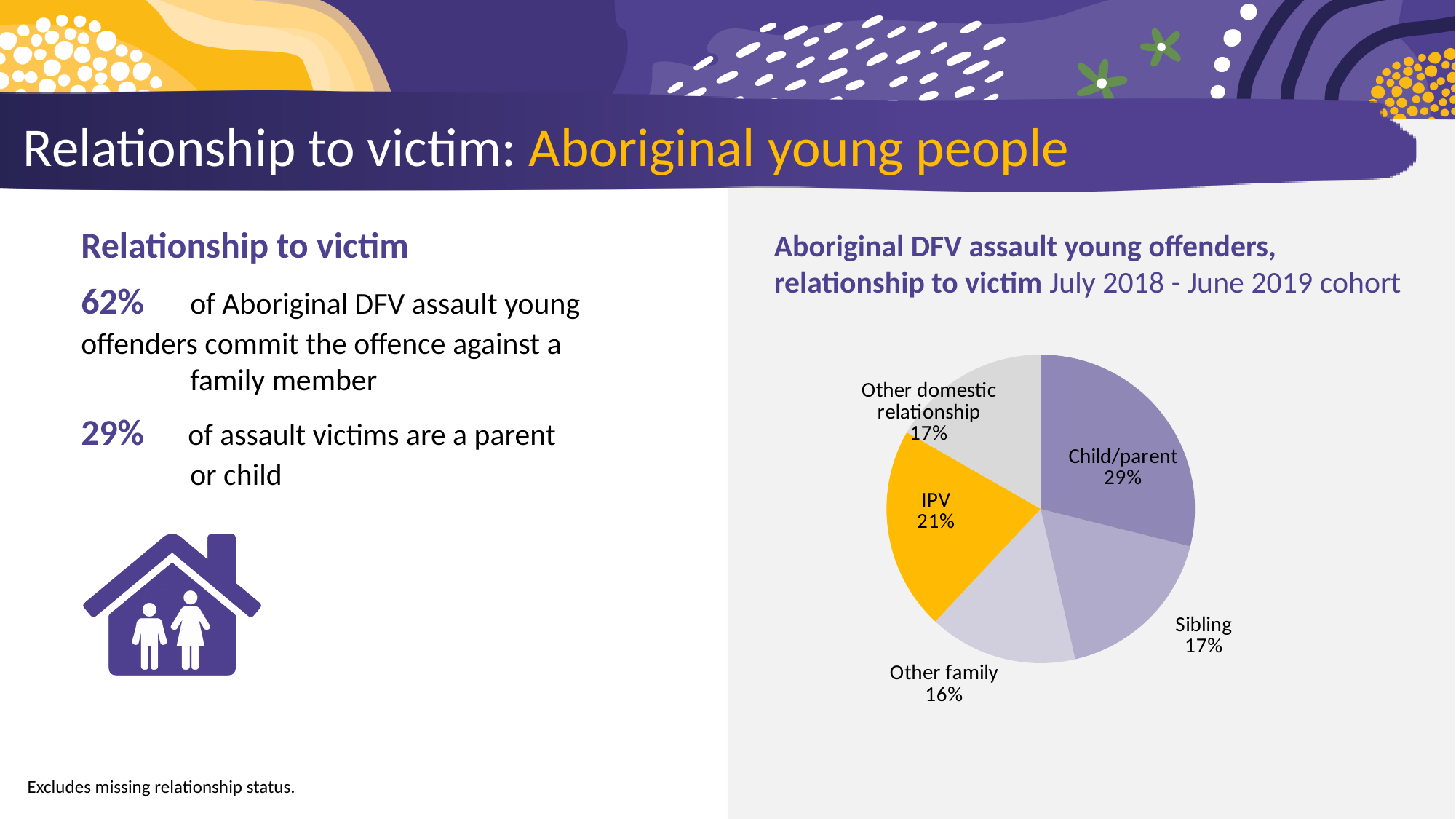
What is the difference in percentage points between Child/parent and IPV? 8% What is the share for Other domestic relationship in the pie chart? 17% What type of chart is shown on the slide? Pie chart How many categories are shown in the pie chart? 5 What is the share for Sibling in the pie chart? 17% Which is larger, the share for IPV or the share for Sibling? IPV Which relationship category has the largest share of the pie? Child/parent What is the share for Other family in the pie chart? 16% Which cohort period does the pie chart title refer to? July 2018 - June 2019 What percentage of Aboriginal DFV assault young offenders committed the offence against a child/parent? 29% What is the share for IPV in the pie chart? 21% Which relationship category has the smallest share of the pie? Other family